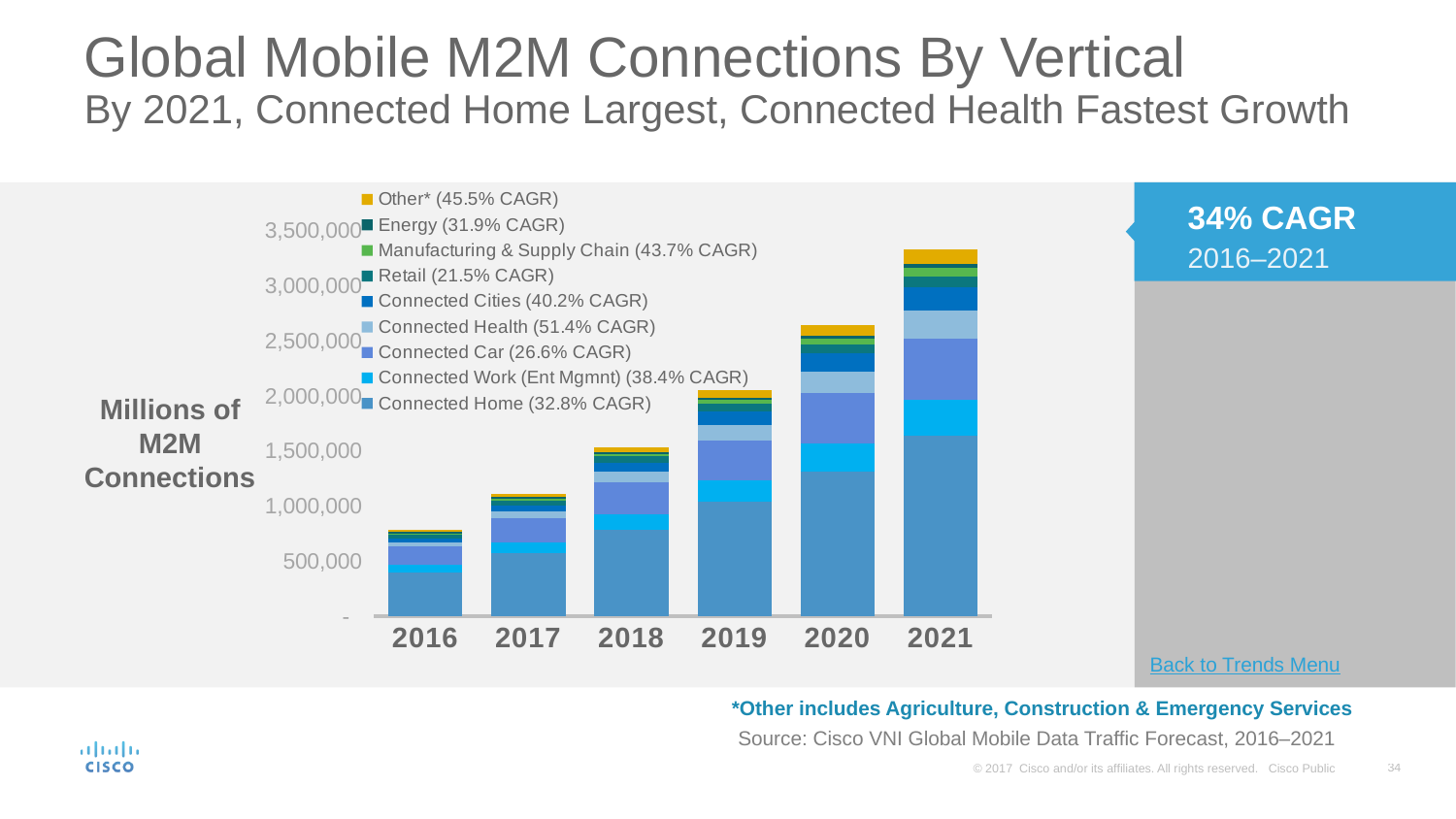
Is the total stacked bar for 2016 greater or less than 1,000,000? less Is the Connected Home segment for 2016 greater or less than 500,000? less According to the legend, what is the CAGR for Connected Health? 51.4% CAGR Is the total stacked bar for 2021 greater or less than 3,000,000? greater How many years are shown along the x axis of the chart? 6 Which year has the larger total bar, 2017 or 2020? 2020 Do the total M2M connections rise or fall from 2016 to 2021? Rise Which year has the shortest stacked bar? 2016 How many series does the chart's legend list? 9 What kind of chart is shown on the slide? Stacked bar chart Which year has the tallest stacked bar? 2021